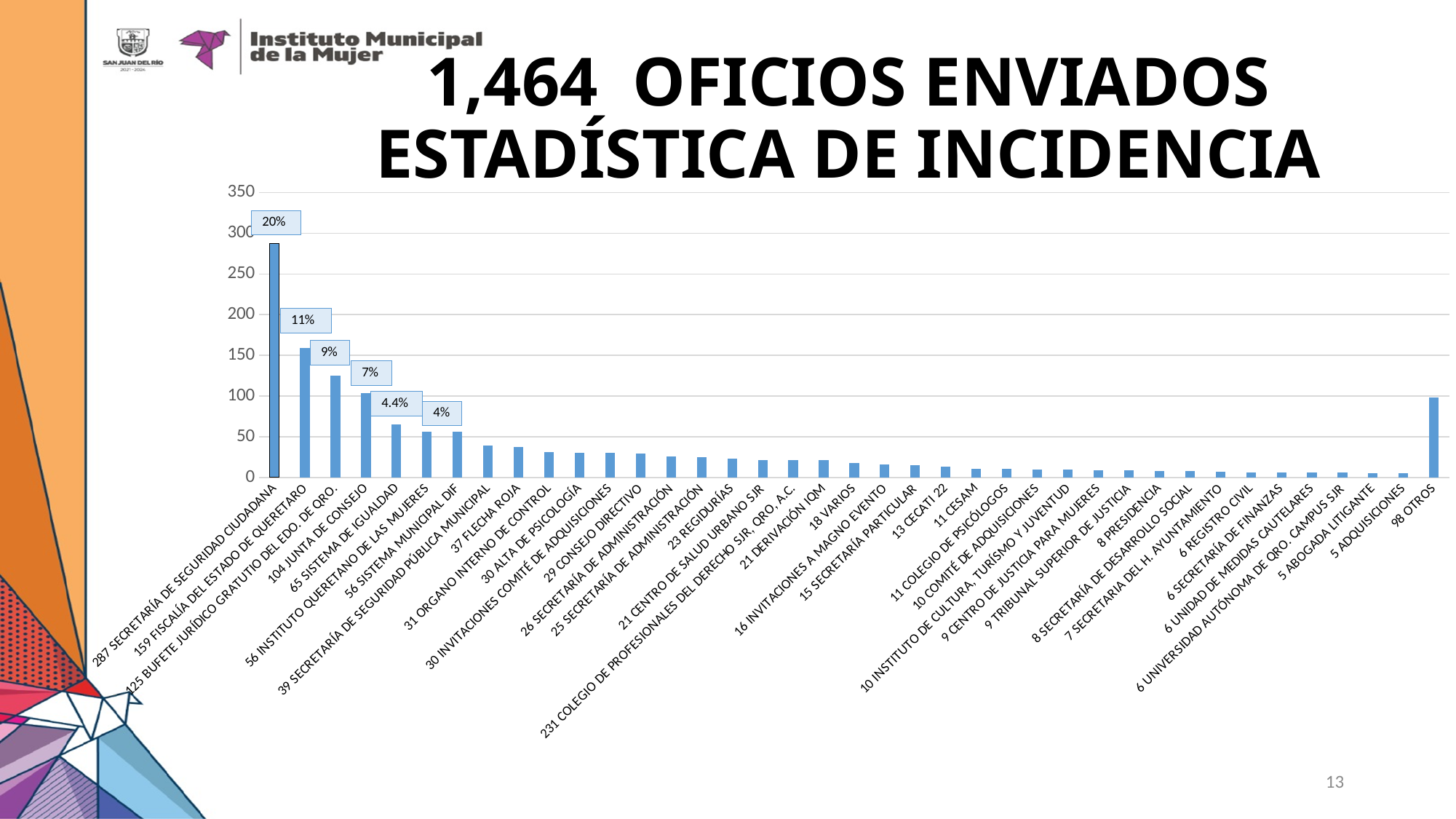
What percentage label is shown above the bar for Sistema de Igualdad? 4.4% Is the value for Flecha Roja greater or less than 50? less What kind of chart is shown on the slide? bar chart How many oficios were sent to Junta de Consejo? 104 How many oficios were sent to Fiscalía del Estado de Querétaro? 159 How many oficios are in the Otros category? 98 Excluding the final Otros bar, do the values rise or fall from left to right along the x axis? fall Which received more oficios, Bufete Jurídico Gratuito del Edo. de Qro. or Sistema de Igualdad? Bufete Jurídico Gratuito del Edo. de Qro. Which category has the highest number of oficios? Secretaría de Seguridad Ciudadana What total number of oficios enviados is stated in the slide title? 1,464 What is the difference between the oficios sent to Secretaría de Seguridad Ciudadana and those sent to Fiscalía del Estado de Querétaro? 128 How many oficios were sent to Secretaría de Seguridad Ciudadana? 287